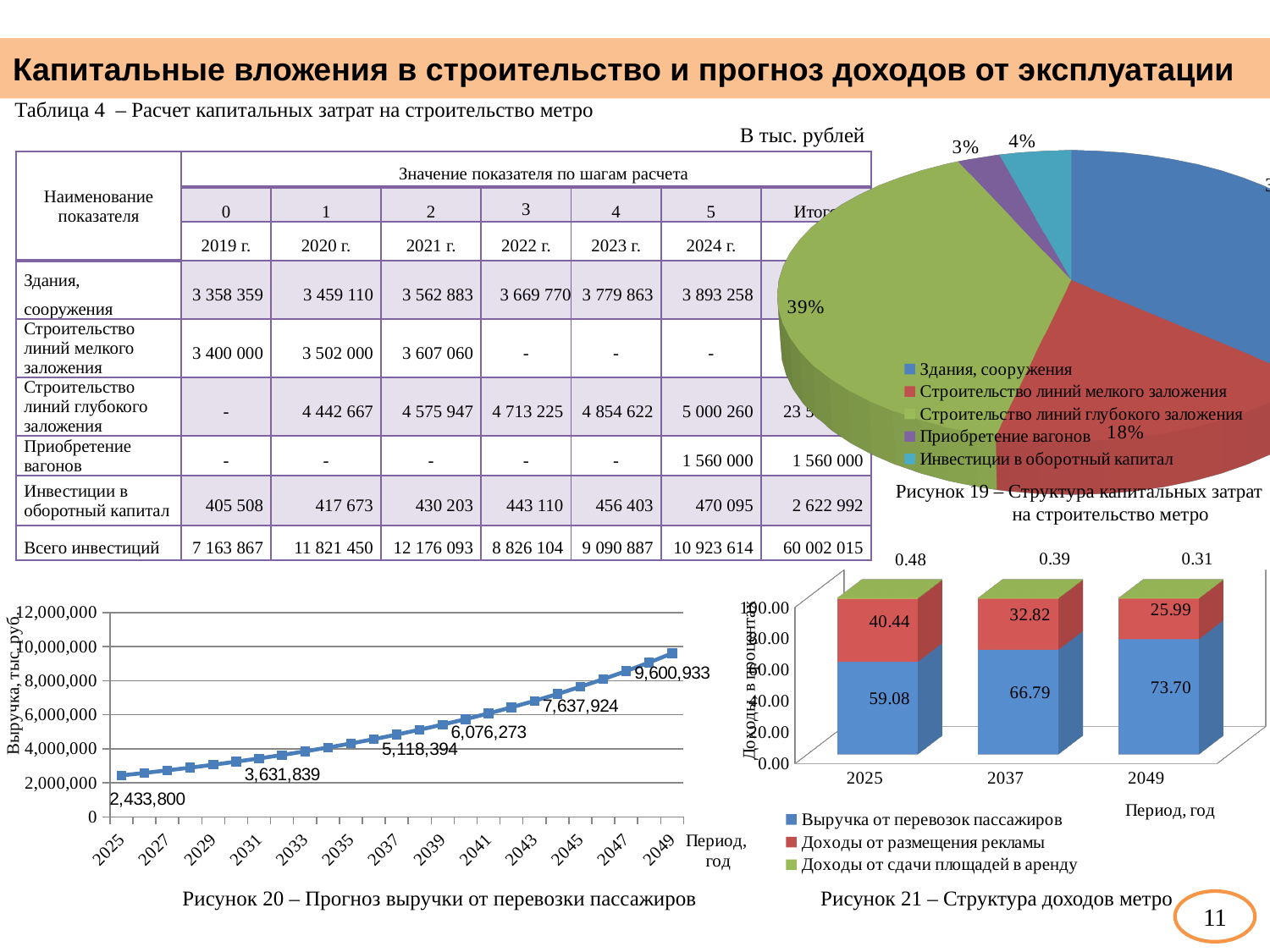
In the stacked bar chart 'Рисунок 21', what is the value of 'Доходы от размещения рекламы' for 2025? 40.44 In the stacked bar chart 'Рисунок 21', how many periods are shown on the x axis? 3 In the line chart 'Рисунок 20 – Прогноз выручки от перевозки пассажиров', what is the value for 2025? 2,433,800 In the line chart 'Рисунок 20', do the values rise or fall from 2025 to 2049? rise What kind of chart is 'Рисунок 20 – Прогноз выручки от перевозки пассажиров'? line chart In the pie chart 'Рисунок 19', what share does 'Приобретение вагонов' have? 3% In the stacked bar chart 'Рисунок 21', what is the difference between 'Выручка от перевозок пассажиров' in 2049 and in 2025? 14.62 In the line chart 'Рисунок 20', what is the value for 2049? 9,600,933 In the pie chart 'Рисунок 19 – Структура капитальных затрат на строительство метро', what share does 'Строительство линий глубокого заложения' have? 39% In the pie chart 'Рисунок 19', what share does 'Инвестиции в оборотный капитал' have? 4% In the stacked bar chart 'Рисунок 21 – Структура доходов метро', what is the value of 'Выручка от перевозок пассажиров' for 2049? 73.70 How many entries does the legend of the pie chart 'Рисунок 19' list? 5